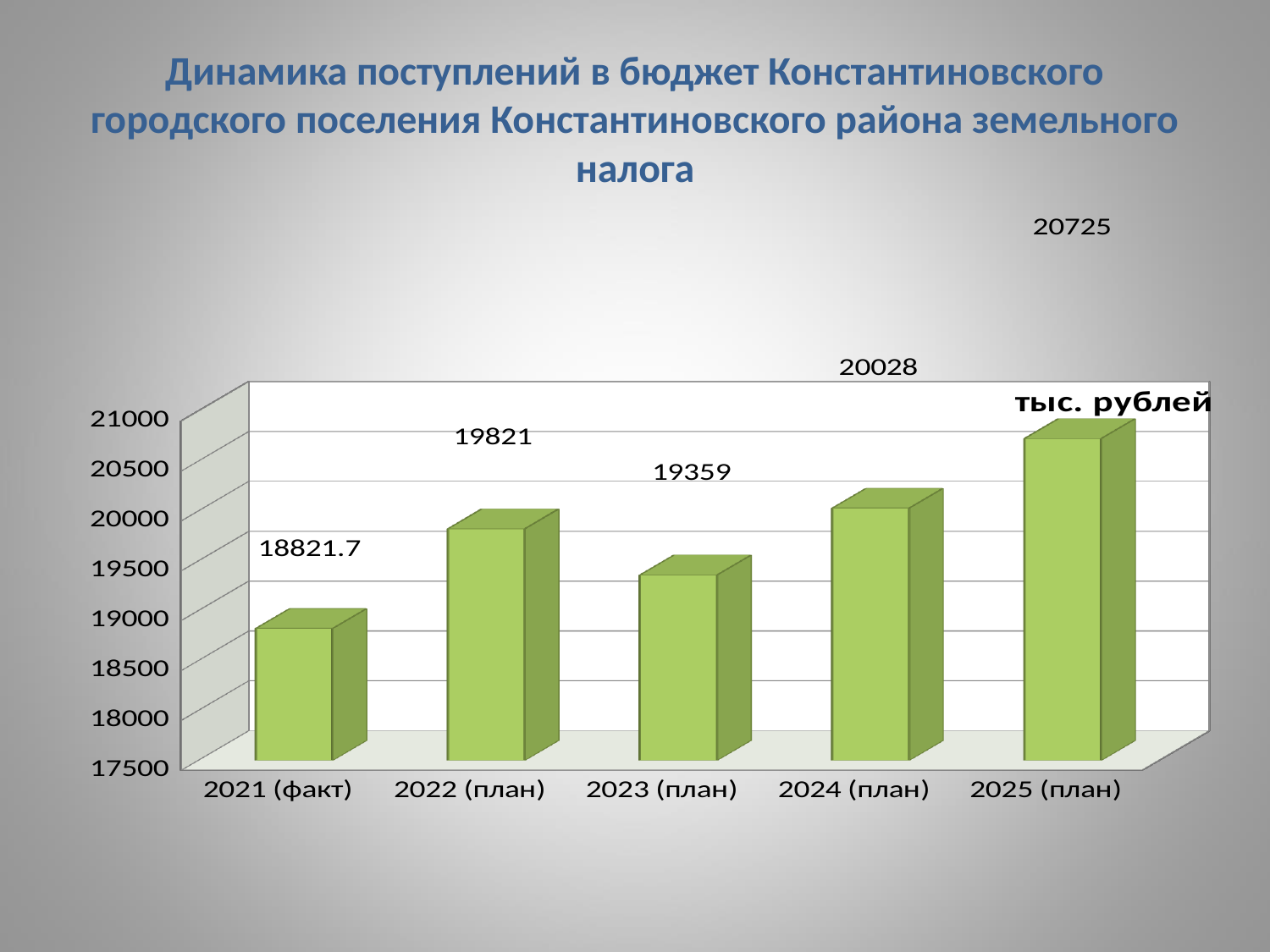
What unit of measurement is indicated on the chart? тыс. рублей What is the value for 2021 (факт)? 18821.7 Is the value for 2024 (план) greater or less than 20000? greater Which category has the highest value? 2025 (план) Which is larger, the value for 2022 (план) or the value for 2023 (план)? 2022 (план) What is the difference between the values for 2022 (план) and 2023 (план)? 462 What is the value for 2025 (план)? 20725 What is the difference between the values for 2025 (план) and 2024 (план)? 697 What is the value for 2023 (план)? 19359 Which category has the lowest value? 2021 (факт) How many categories are shown on the x axis? 5 What kind of chart is shown on the slide? bar chart